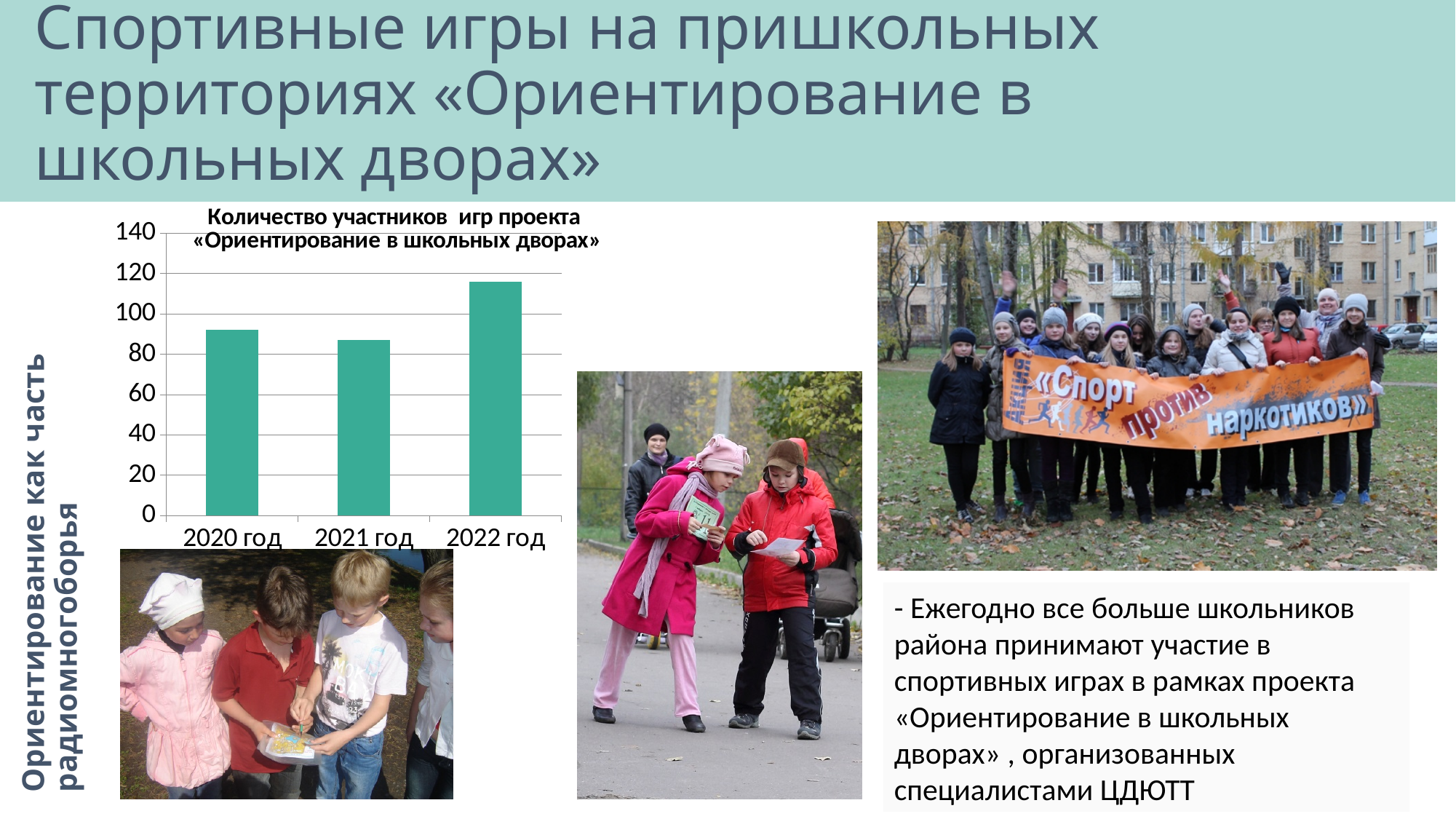
Which is larger, the value for 2021 год or the value for 2022 год? 2022 год Is the value for 2020 год greater or less than 100? less Is the value for 2020 год greater or less than 80? greater Which is larger, the value for 2022 год or the value for 2020 год? 2022 год Is the value for 2021 год greater or less than 100? less What kind of chart is shown on the slide? bar chart What is the title of the chart? Количество участников игр проекта «Ориентирование в школьных дворах» Which year has the highest number of participants in the chart? 2022 год How many categories (years) are shown on the x axis of the chart? 3 Do the values rise steadily from 2020 год to 2022 год? No, they fall in 2021 and then rise in 2022